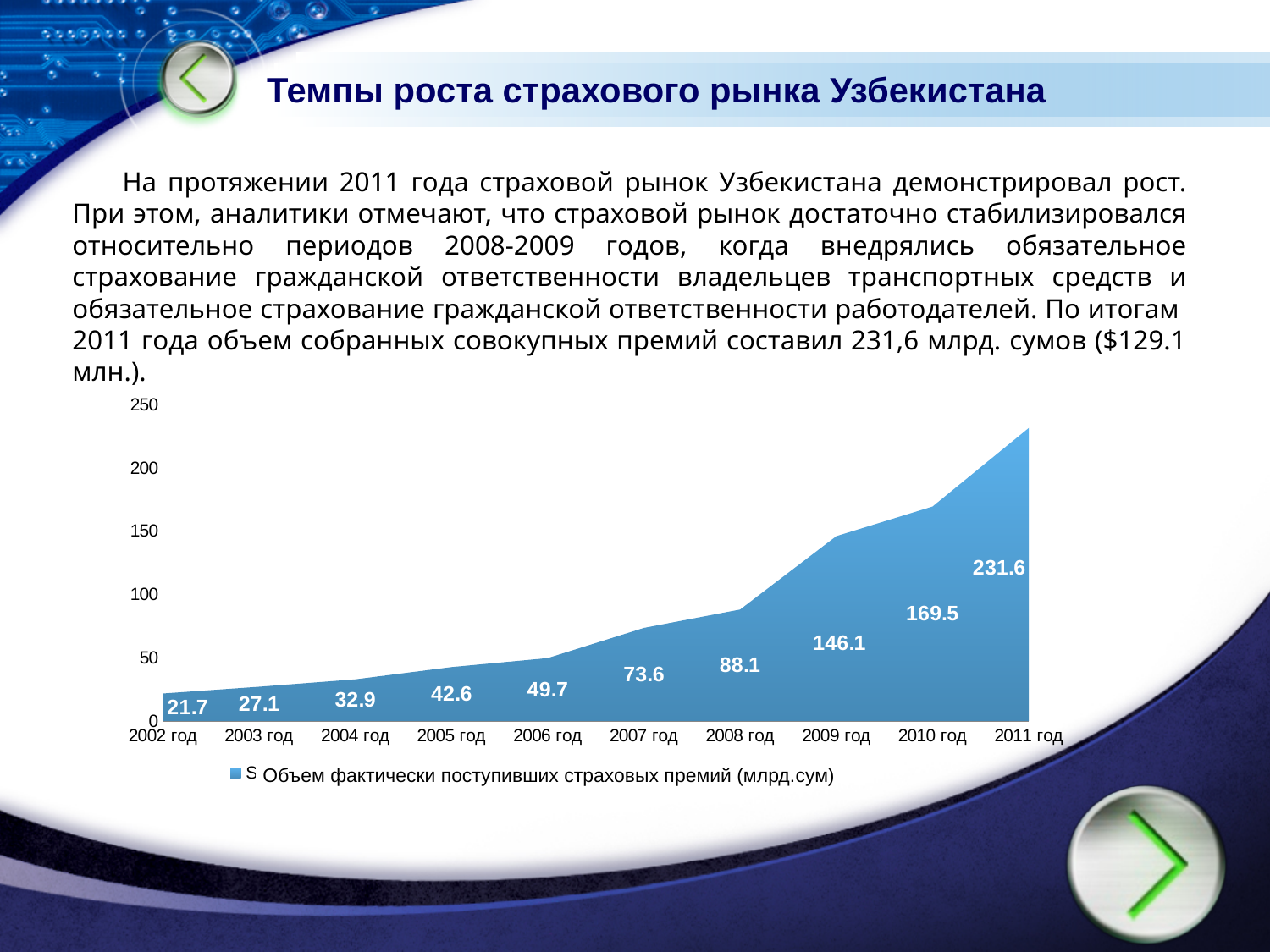
What is the difference between the values for 2011 год and 2010 год? 62.1 Is the value for 2009 год greater or less than 100? greater Which is larger, the value for 2007 год or the value for 2006 год? 2007 год Which year has the lowest value? 2002 год What is the value for 2005 год? 42.6 What kind of chart is shown on the slide? area chart What is the difference between the values for 2009 год and 2008 год? 58 Do the values rise or fall from 2002 год to 2011 год? rise What is the value for 2011 год? 231.6 What is the value for 2008 год? 88.1 How many years are shown on the x axis? 10 Which year has the highest value? 2011 год